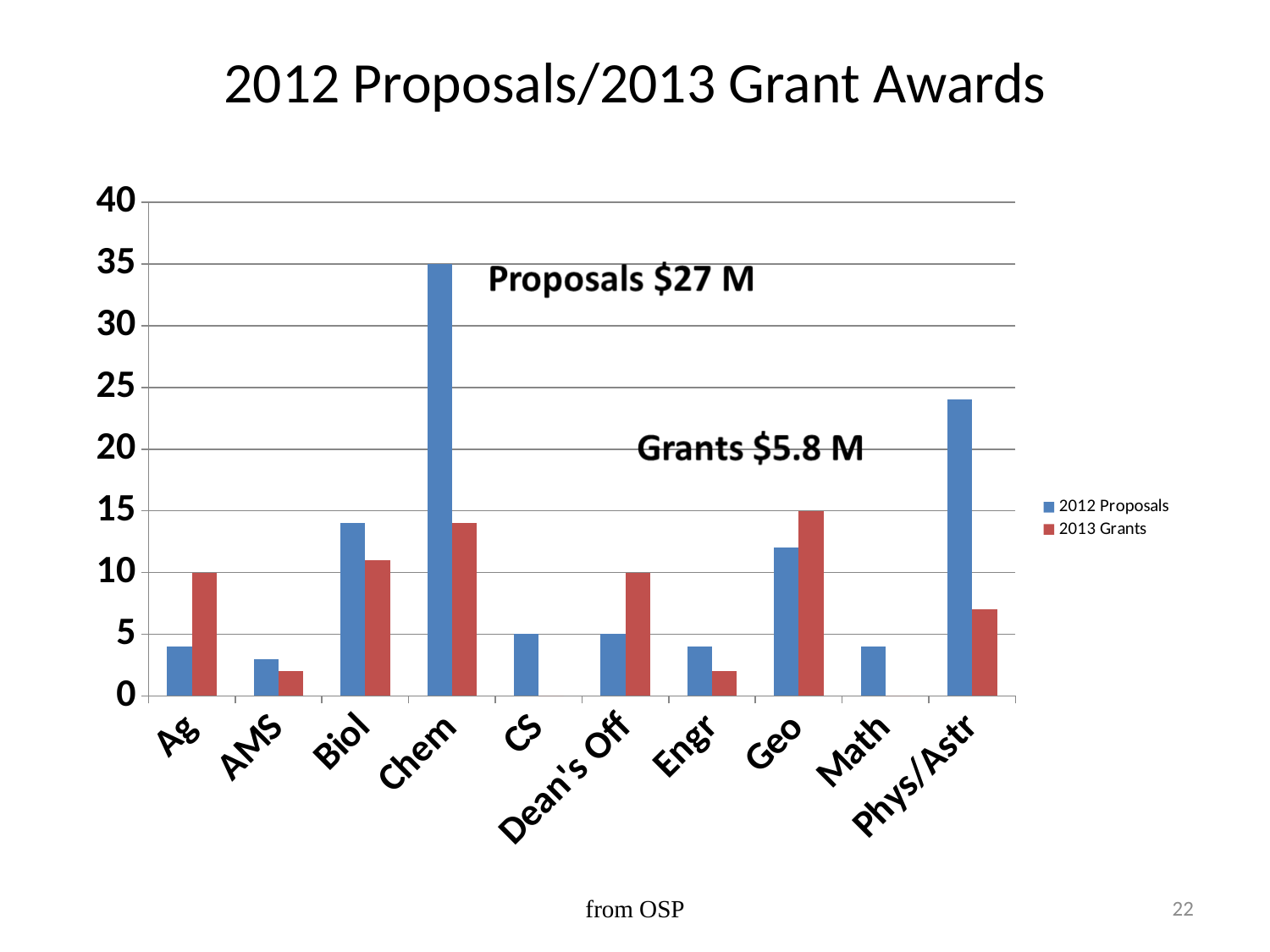
Is the 2013 Grants value for Biol greater or less than 10? greater What is the title of the slide? 2012 Proposals/2013 Grant Awards For Geo, which is larger: 2012 Proposals or 2013 Grants? 2013 Grants Is the 2012 Proposals value for Phys/Astr greater or less than 20? greater Which department has the highest 2012 Proposals value? Chem How many series does the legend list? 2 What total dollar amount does the chart annotation give for Grants? $5.8 M What is the 2012 Proposals value for Chem? 35 For Biol, which is larger: 2012 Proposals or 2013 Grants? 2012 Proposals Which department has the highest 2013 Grants value? Geo What kind of chart is shown on the slide? bar chart How many departments (categories) are shown on the x axis? 10